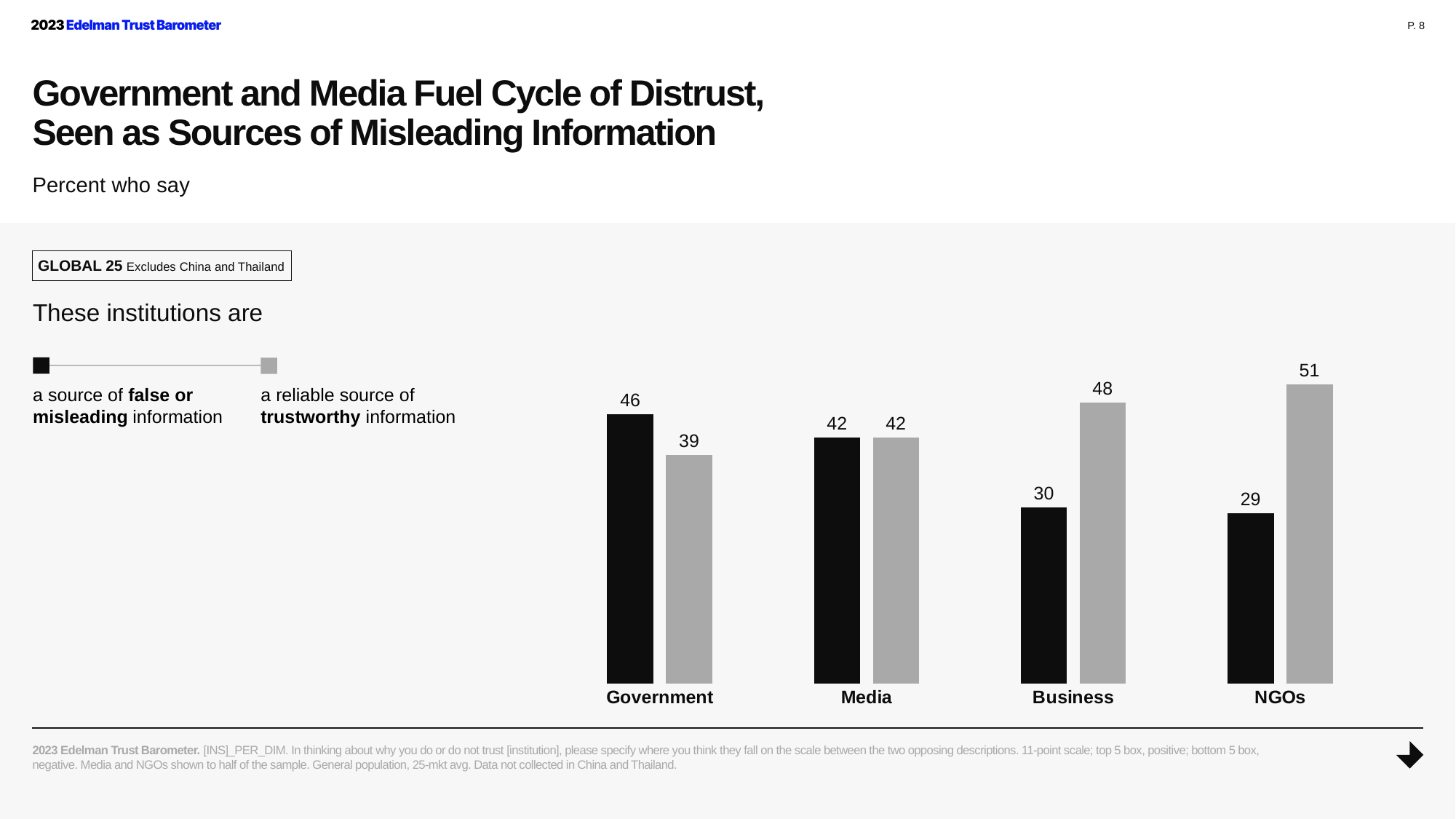
What kind of chart is shown on the slide? Bar chart What percent say Business is a source of false or misleading information? 30 Which institution has the lowest value for being a source of false or misleading information? NGOs For Government, which is larger: the 'source of false or misleading information' value or the 'reliable source of trustworthy information' value? source of false or misleading information How many institutions are shown on the chart? 4 Which institution has the highest value for being a source of false or misleading information? Government What colour are the bars for 'a source of false or misleading information'? Black What is the difference between the 'reliable source of trustworthy information' and 'source of false or misleading information' values for NGOs? 22 How many series does the legend list? 2 What percent say Government is a source of false or misleading information? 46 Which institution has the highest value for being a reliable source of trustworthy information? NGOs What percent say NGOs are a reliable source of trustworthy information? 51